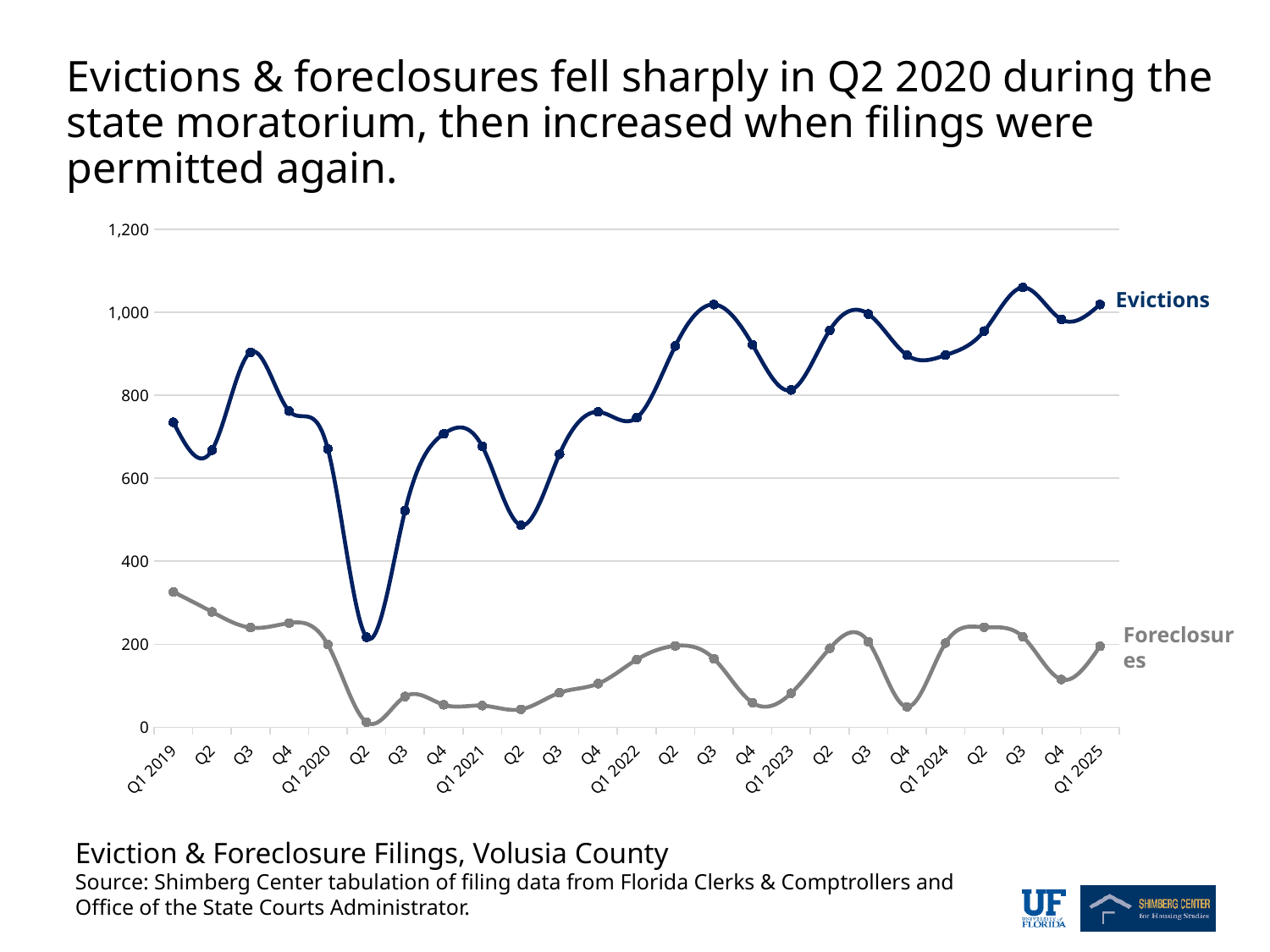
In which quarter is the Foreclosures line at its lowest? Q2 2020 What kind of chart is shown on the slide? line chart Is the Evictions value for Q3 2019 greater or less than 800? greater Is the Evictions value for Q2 2020 greater or less than 400? less How many series are plotted on the chart? 2 In which quarter is the Foreclosures line at its highest? Q1 2019 What is the title of the chart shown below the plot? Eviction & Foreclosure Filings, Volusia County Is the Evictions value for Q2 2021 greater or less than 600? less How many quarterly data points does each line have, from Q1 2019 to Q1 2025? 25 In which quarter is the Evictions line at its lowest? Q2 2020 Which is larger in Q1 2025, Evictions or Foreclosures? Evictions